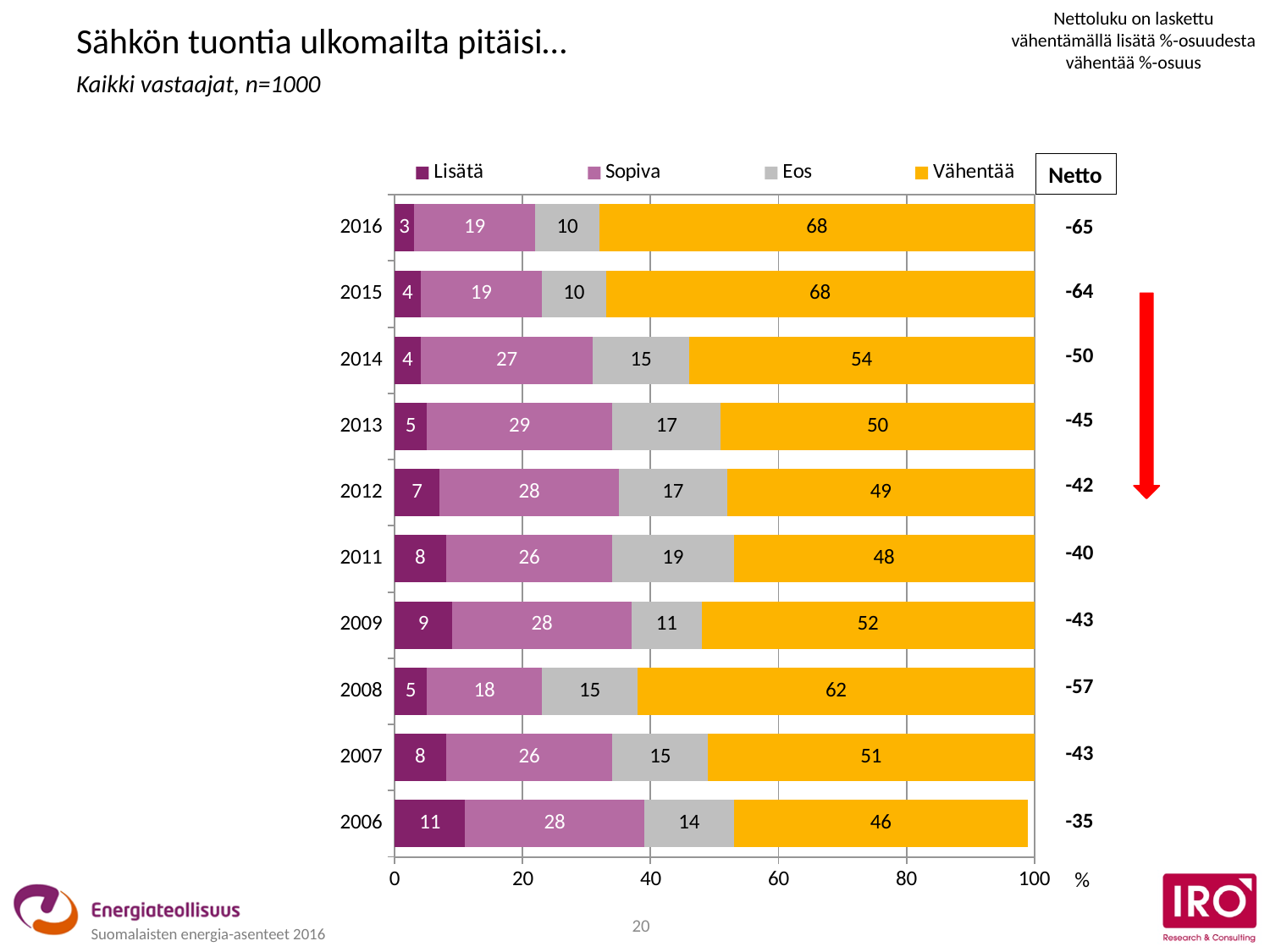
Which year has the lowest Vähentää value? 2006 How many series does the legend list? 4 What is the Vähentää value for 2016? 68 What is the difference between the Vähentää values for 2008 and 2007? 11 What is the Eos value for 2011? 19 What is the Lisätä value for 2006? 11 What is the Sopiva value for 2013? 29 Which is larger, the Sopiva value for 2014 or the Sopiva value for 2008? 2014 How many years are shown on the chart? 10 Which year has the highest Lisätä value? 2006 What is the total of the stacked bar for 2006? 99 What kind of chart is shown on the slide? Stacked bar chart